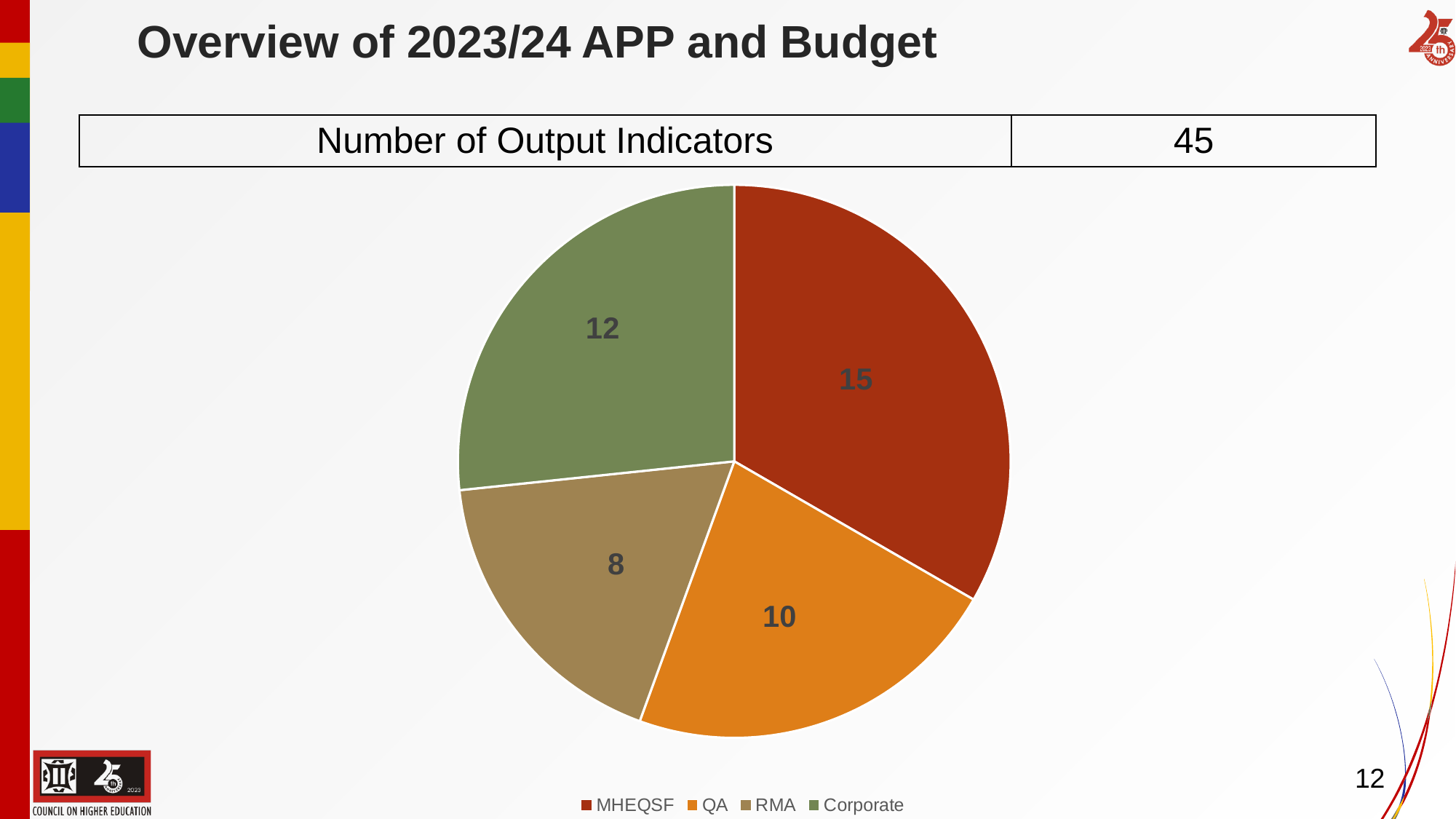
What is the difference between the MHEQSF and RMA values? 7 How many output indicators does the MHEQSF slice represent? 15 How many slices does the pie chart have? 4 What is the total of all the slices in the pie chart? 45 What is the value of the QA slice? 10 Which is larger, the Corporate slice or the QA slice? Corporate Which category has the largest slice of the pie? MHEQSF What share of the pie does the MHEQSF slice represent? one third What is the value of the RMA slice? 8 What is the value of the Corporate slice? 12 Which category has the smallest slice of the pie? RMA What type of chart is shown on the slide? pie chart